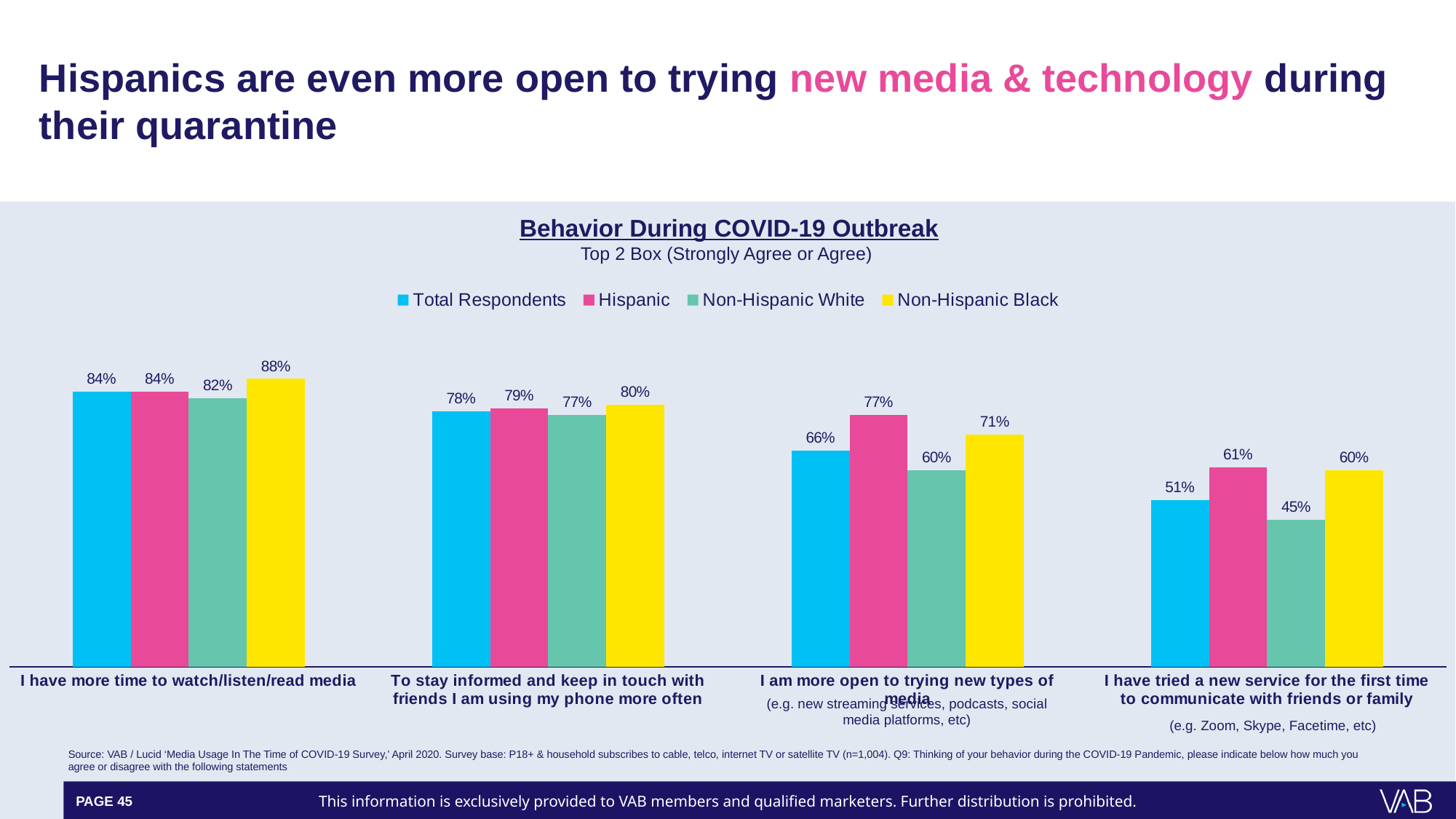
Do the Total Respondents values rise or fall across the categories from left to right? Fall What is the value for Hispanic respondents for 'I am more open to trying new types of media'? 77% Which is larger for 'I have tried a new service for the first time to communicate with friends or family': the Hispanic value or the Total Respondents value? Hispanic Which group has the lowest value for 'I have tried a new service for the first time to communicate with friends or family'? Non-Hispanic White How many statement categories are shown on the x axis? 4 What is the title of the chart? Behavior During COVID-19 Outbreak What is the value for Total Respondents for 'To stay informed and keep in touch with friends I am using my phone more often'? 78% What kind of chart is shown on the slide? Bar chart What is the value for Non-Hispanic White respondents for 'I have tried a new service for the first time to communicate with friends or family'? 45% What is the difference between the Hispanic and Non-Hispanic White values for 'I am more open to trying new types of media'? 17 percentage points Which group has the highest value for 'I have more time to watch/listen/read media'? Non-Hispanic Black How many series does the legend list? 4